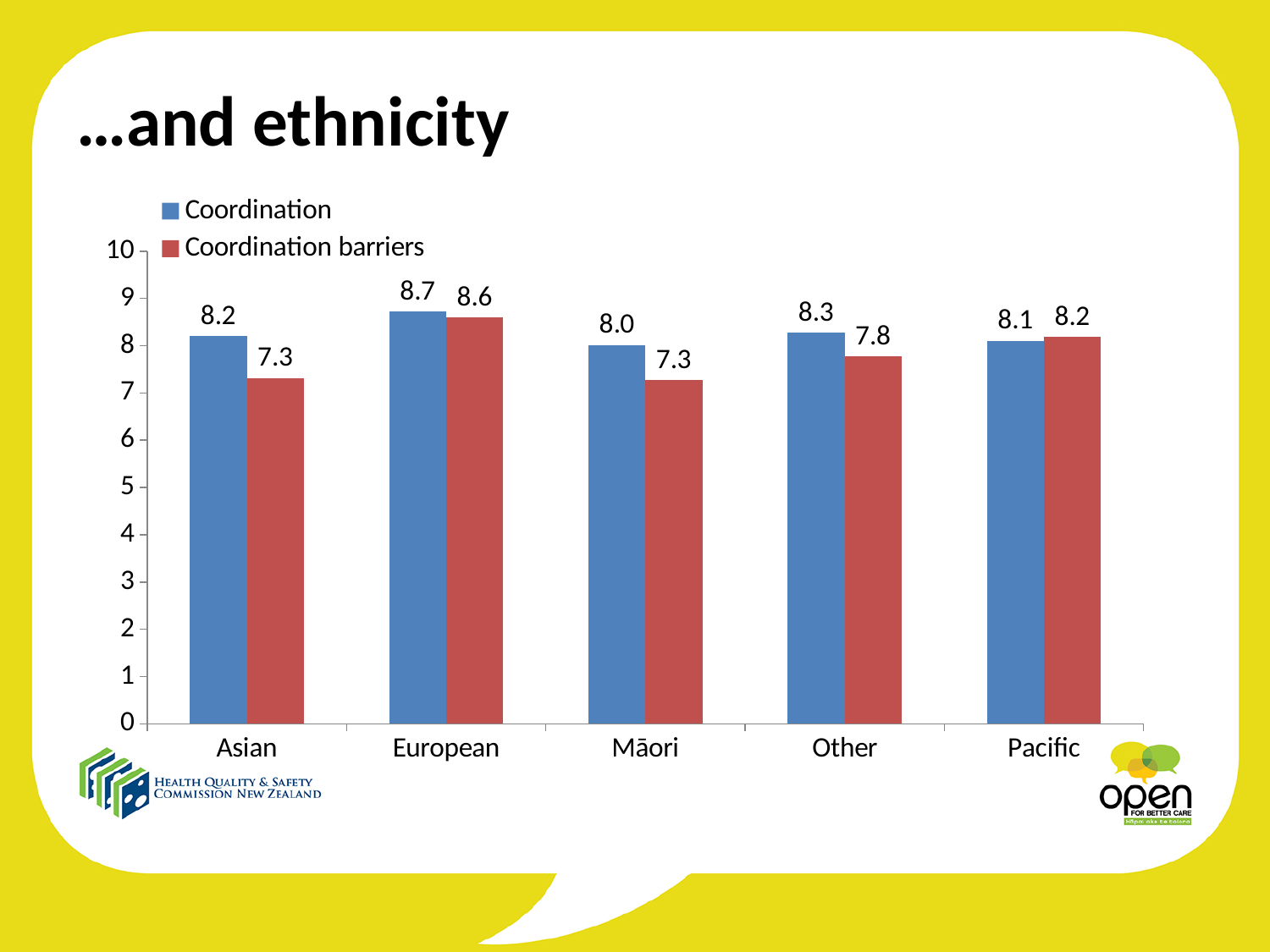
What is the Coordination barriers value for Asian? 7.3 What is the Coordination value for European? 8.7 Which is larger for Other: the Coordination value or the Coordination barriers value? Coordination What colour are the Coordination barriers bars? Red Which ethnicity has the lowest Coordination value? Māori What is the difference between the Coordination barriers values for European and Asian? 1.3 Which ethnicity has the highest Coordination value? European How many series does the legend list? 2 What is the difference between the Coordination and Coordination barriers values for Māori? 0.7 What is the Coordination barriers value for Other? 7.8 How many ethnicity categories are shown on the x axis? 5 What kind of chart is shown on the slide? Bar chart